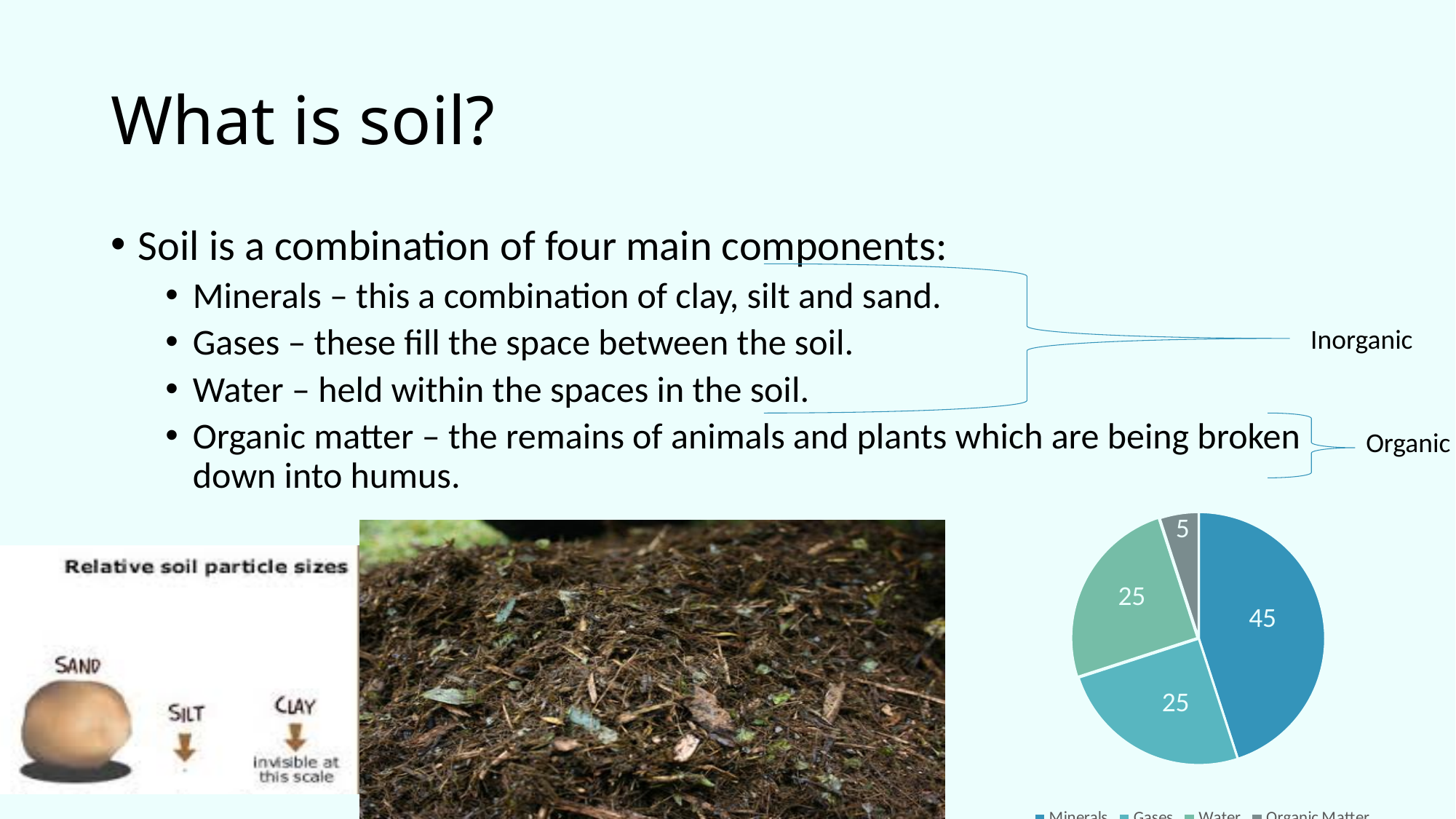
Which is larger in the pie chart, Minerals or Water? Minerals What is the value shown for Organic Matter in the pie chart? 5 How many entries does the pie chart's legend list? 4 How many slices does the pie chart have? 4 What is the total of all the values shown in the pie chart? 100 What kind of chart is shown on the slide? pie chart Which component has the smallest slice in the pie chart? Organic Matter What is the value shown for Minerals in the pie chart? 45 What share of the pie chart does the Minerals slice represent? 45% What is the value shown for Gases in the pie chart? 25 Which component has the largest slice in the pie chart? Minerals What is the difference between the values for Minerals and Organic Matter in the pie chart? 40